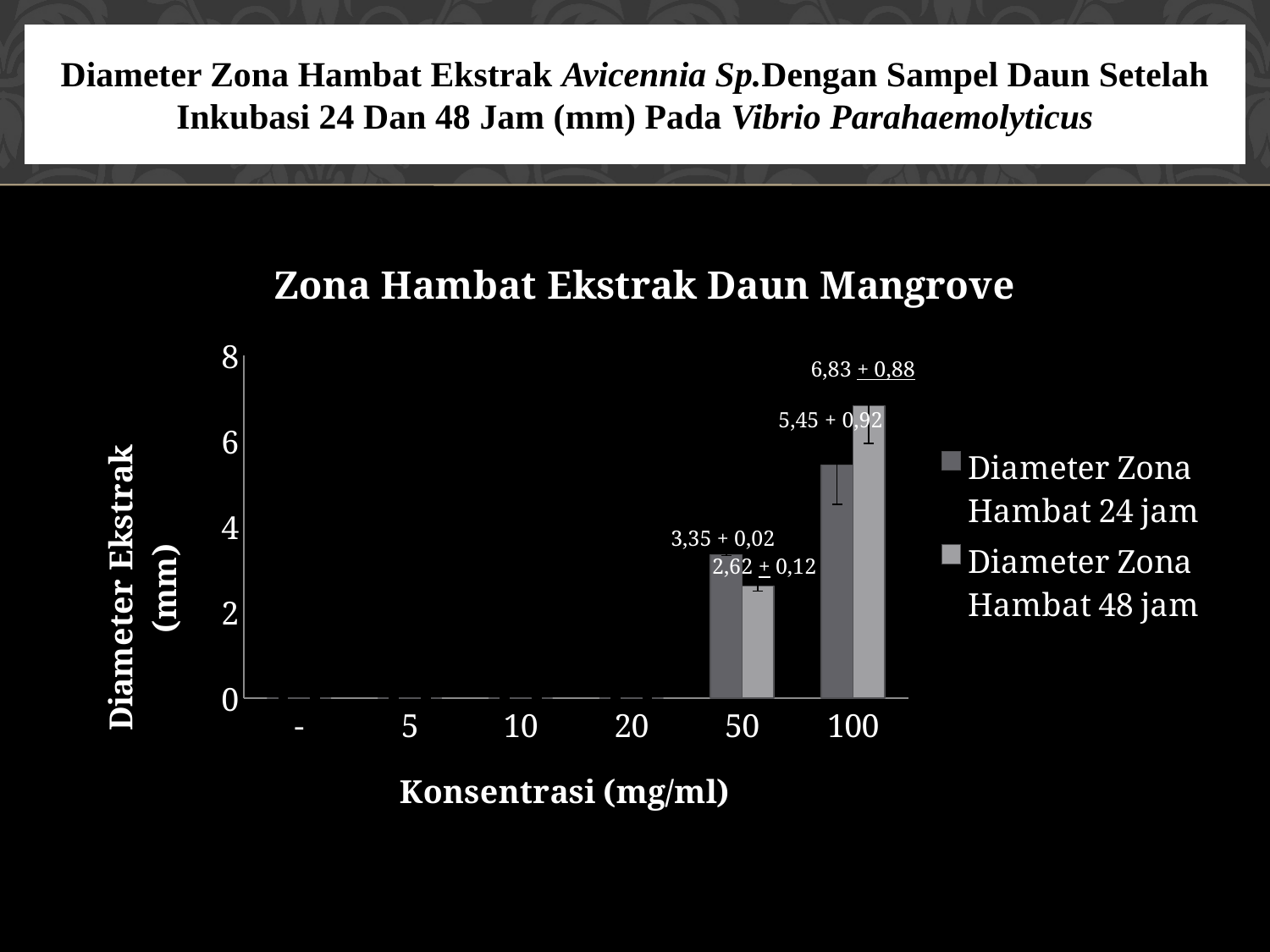
What is the data label for Diameter Zona Hambat 24 jam at a concentration of 100 mg/ml? 5,45 + 0,92 What is the data label for Diameter Zona Hambat 48 jam at a concentration of 100 mg/ml? 6,83 + 0,88 How many series does the legend list? 2 What type of chart is shown on the slide? bar chart At a concentration of 100 mg/ml, which series has the larger diameter: 24 jam or 48 jam? Diameter Zona Hambat 48 jam At which concentration is the Diameter Zona Hambat 48 jam highest? 100 What is the data label for Diameter Zona Hambat 24 jam at a concentration of 50 mg/ml? 3,35 + 0,02 At a concentration of 50 mg/ml, which series has the larger diameter: 24 jam or 48 jam? Diameter Zona Hambat 24 jam What is the data label for Diameter Zona Hambat 48 jam at a concentration of 50 mg/ml? 2,62 + 0,12 How many concentration categories are shown on the x axis? 6 Is the Diameter Zona Hambat 48 jam at 100 mg/ml greater or less than 6? greater What is the title of the chart? Zona Hambat Ekstrak Daun Mangrove